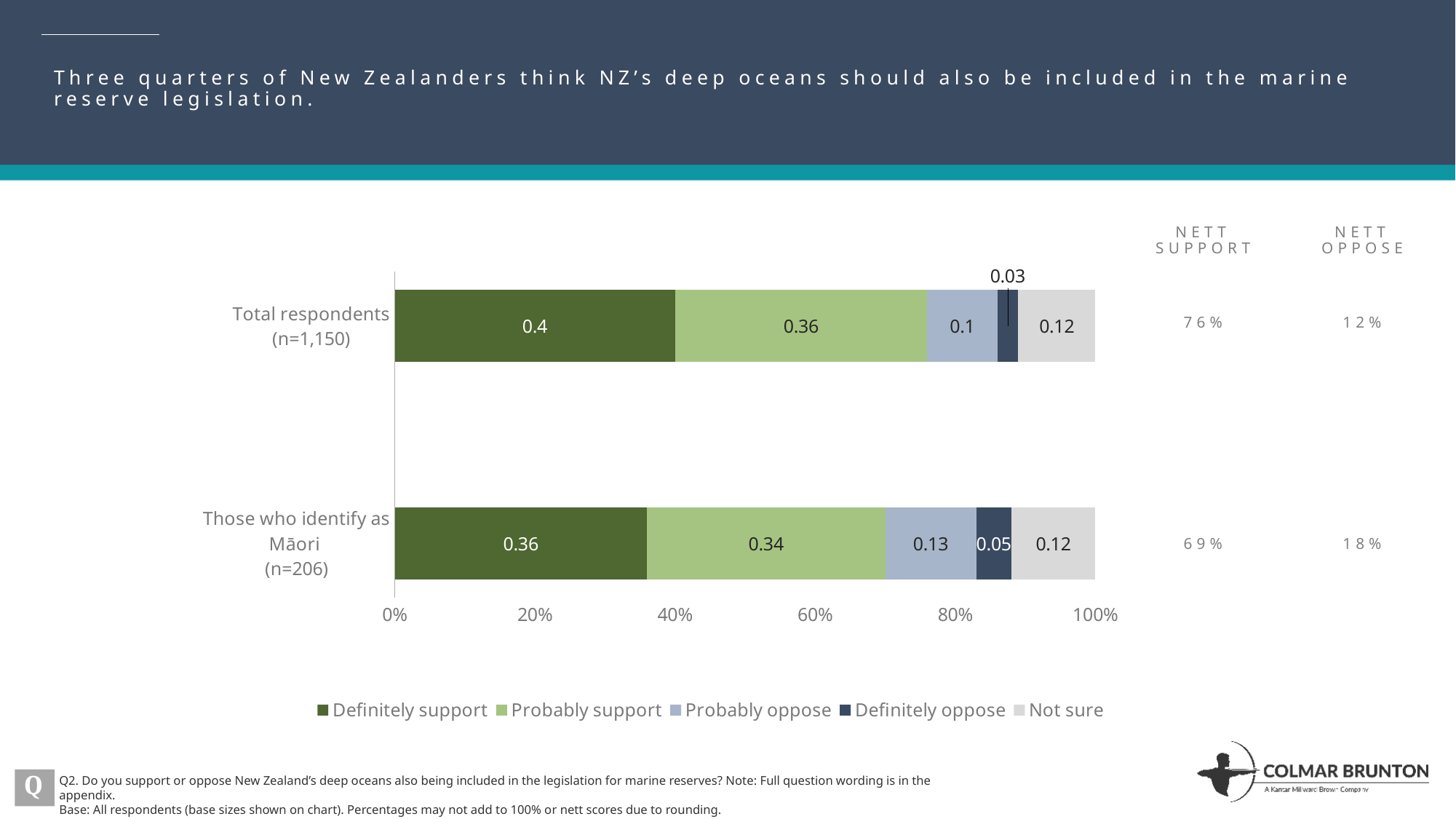
How many respondent groups (categories) are plotted on the chart? 2 How many series does the legend list? 5 What is the Not sure value for Those who identify as Māori (n=206)? 0.12 What is the Probably support value for Those who identify as Māori (n=206)? 0.34 What is the Definitely support value for Total respondents (n=1,150)? 0.4 Which segment is the largest in the Total respondents (n=1,150) bar? Definitely support What is the difference between the Definitely support values for Total respondents and Those who identify as Māori? 0.04 What is the NETT SUPPORT figure shown for Total respondents (n=1,150)? 76% Which segment is the smallest in the Those who identify as Māori (n=206) bar? Definitely oppose What is the Definitely oppose value for Total respondents (n=1,150)? 0.03 Which group has the larger Probably oppose value, Total respondents or Those who identify as Māori? Those who identify as Māori What kind of chart is shown on the slide? Stacked bar chart